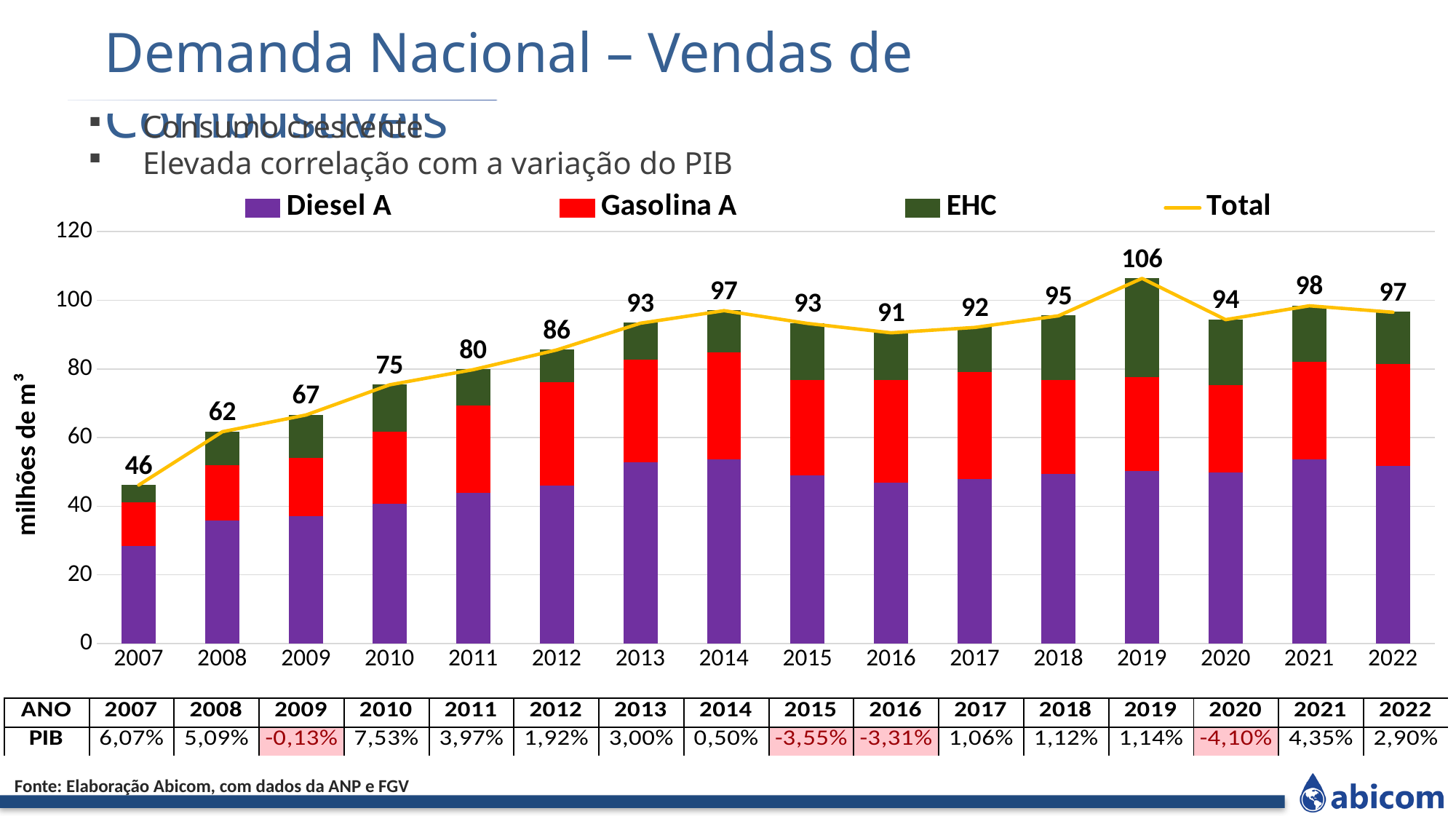
Did the total rise or fall from 2007 to 2014? Rise Which year has the highest total? 2019 Is the Diesel A value for 2022 greater or less than 40? greater How many years are shown on the x axis of the chart? 16 What is the label on the y axis of the chart? milhões de m³ Which year has the lowest total? 2007 What is the total value shown for 2007? 46 What is the difference between the total for 2019 and the total for 2020? 12 What is the total value shown for 2019? 106 How many series does the chart legend list? 4 Which year has a larger total, 2014 or 2016? 2014 What kind of chart is used to show the fuel sales? Stacked bar chart with a line